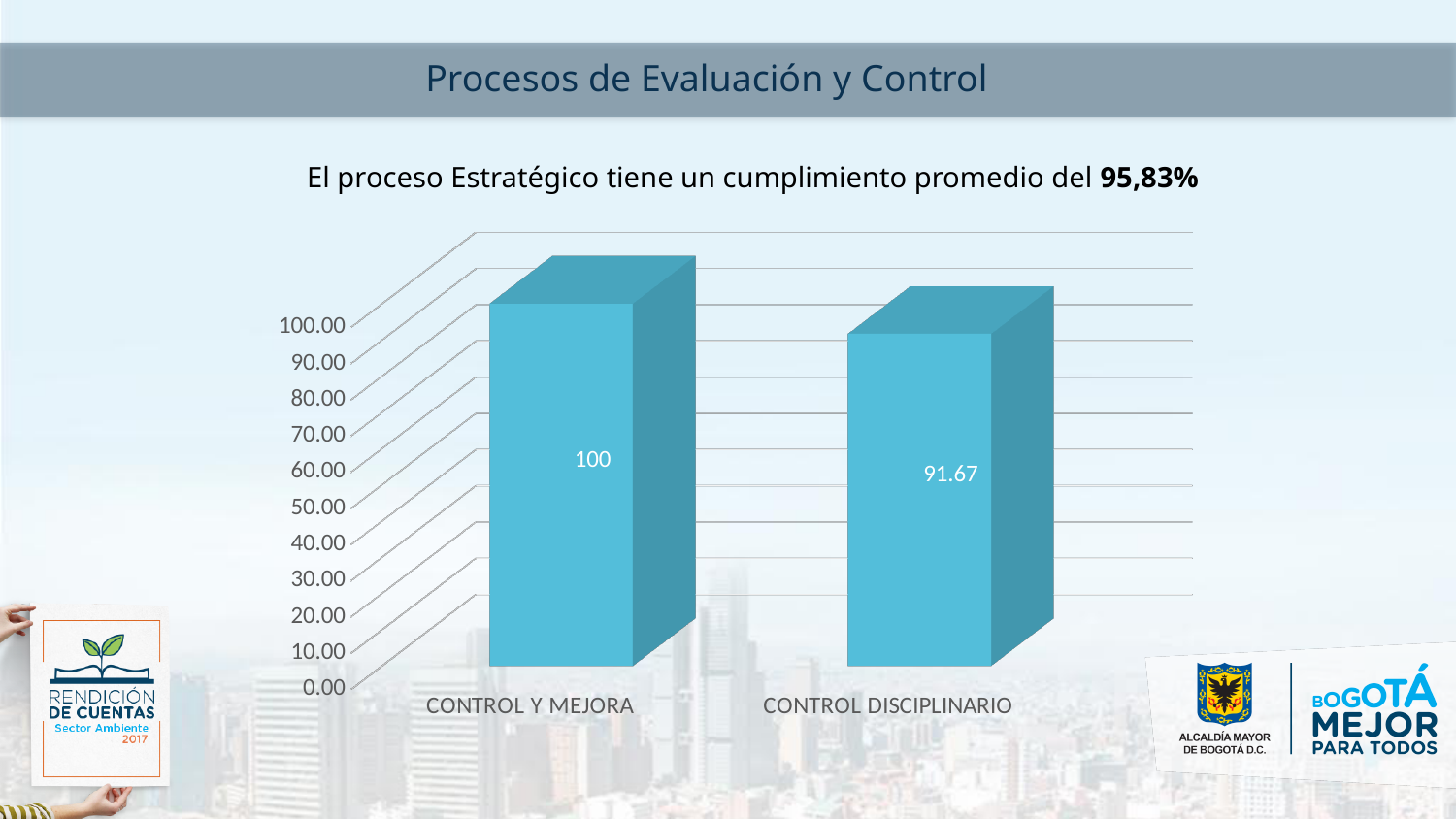
What is the value for CONTROL DISCIPLINARIO? 91.67 Is the value for CONTROL DISCIPLINARIO greater or less than 90.00? greater Which category has the highest value? CONTROL Y MEJORA Which is larger, the value for CONTROL Y MEJORA or the value for CONTROL DISCIPLINARIO? CONTROL Y MEJORA How many categories are shown on the chart? 2 What is the difference between the values for CONTROL Y MEJORA and CONTROL DISCIPLINARIO? 8.33 What is the highest value shown on the chart's vertical axis? 100.00 What kind of chart is shown on the slide? bar chart What is the title of the slide containing the chart? Procesos de Evaluación y Control Do the values rise or fall from CONTROL Y MEJORA to CONTROL DISCIPLINARIO? fall Which category has the lowest value? CONTROL DISCIPLINARIO What is the value for CONTROL Y MEJORA? 100